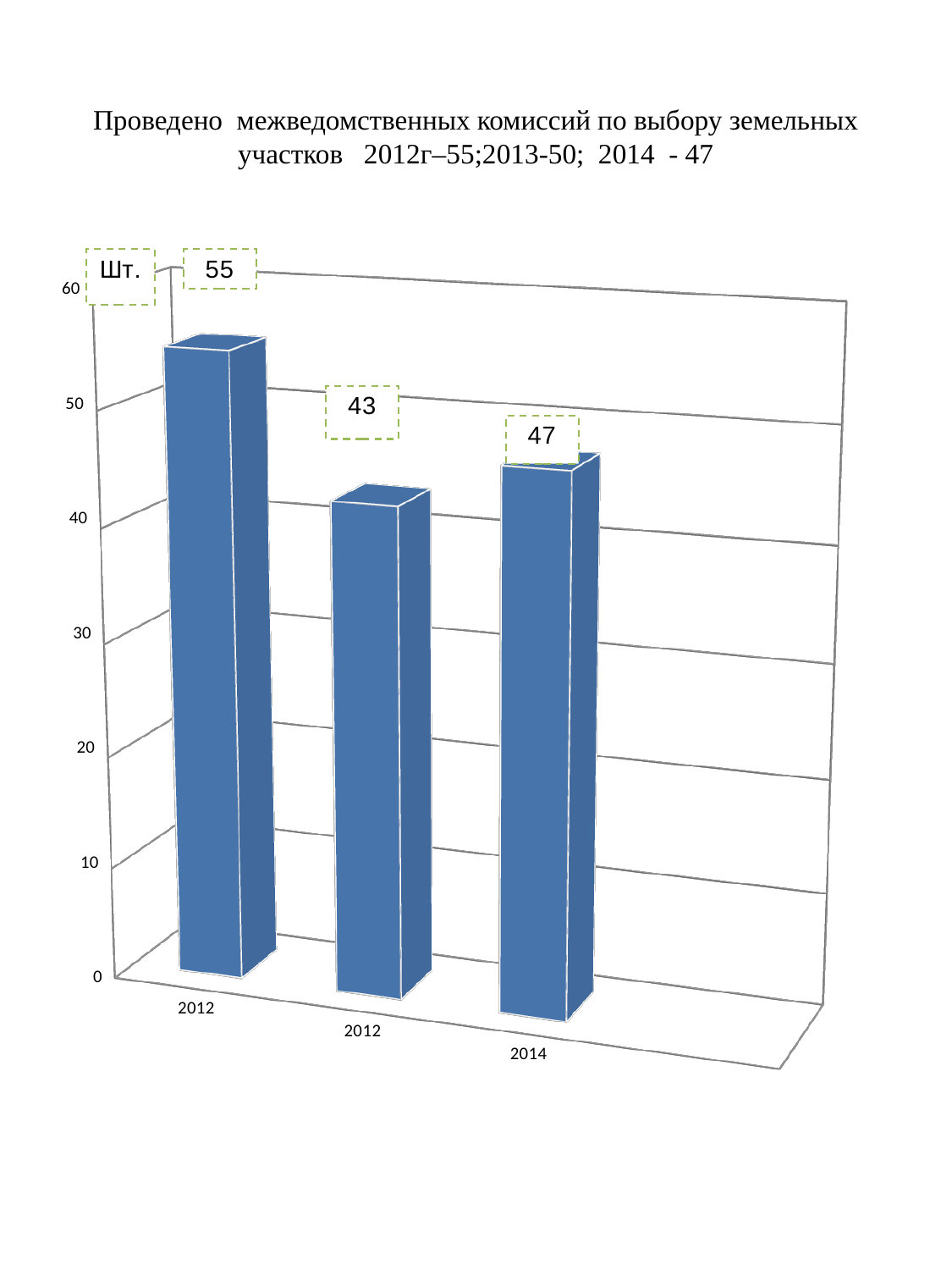
What unit label is shown at the top of the vertical axis? Шт. What is the value shown on the leftmost bar? 55 What kind of chart is shown on the slide? Bar chart Which is larger: the value for 2014 or the value of the middle bar? 2014 What is the difference between the leftmost bar's value and the value for 2014? 8 What is the difference between the value for 2014 and the middle bar's value? 4 What is the value shown on the middle bar? 43 What is the value shown for 2014? 47 Which bar has the lowest value? The middle bar, 43 How many bars are plotted in the chart? 3 Is the value of the middle bar greater or less than 50? less Which bar has the highest value? The leftmost bar (2012), 55